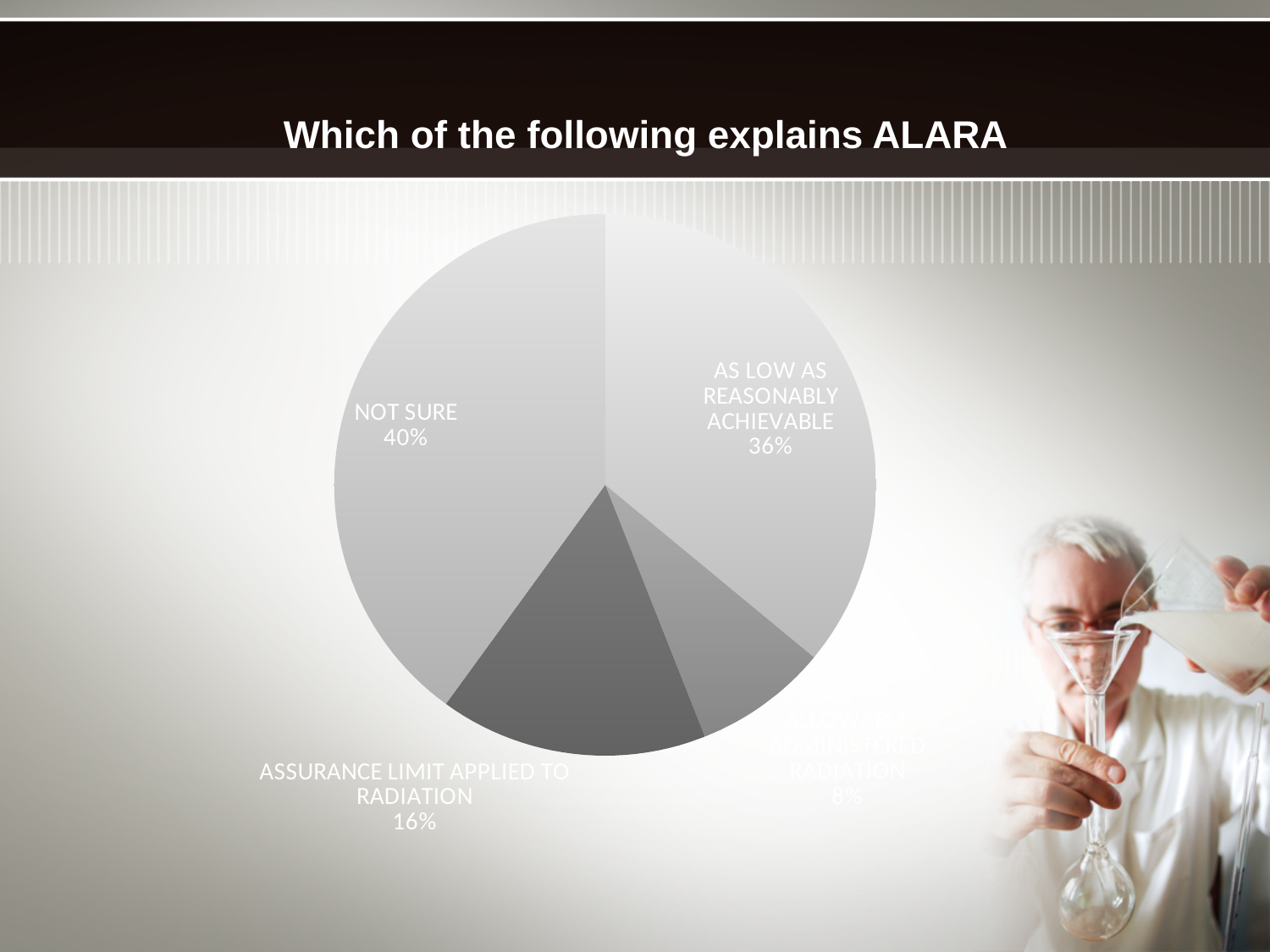
How many slices does the pie chart have? 4 What is the difference in percentage points between NOT SURE and AS LOW AS REASONABLY ACHIEVABLE? 4 percentage points What is the difference in percentage points between AS LOW AS REASONABLY ACHIEVABLE and ASSURANCE LIMIT APPLIED TO RADIATION? 20 percentage points What is the title of the slide? Which of the following explains ALARA Which is larger, ASSURANCE LIMIT APPLIED TO RADIATION or AS LOW AS REASONABLY ACHIEVABLE? AS LOW AS REASONABLY ACHIEVABLE Which slice of the pie chart is the largest? NOT SURE What percentage of the pie is the NOT SURE slice? 40% What percentage is shown for ASSURANCE LIMIT APPLIED TO RADIATION? 16% What kind of chart is shown on the slide? Pie chart Which is larger, the NOT SURE slice or the AS LOW AS REASONABLY ACHIEVABLE slice? NOT SURE What percentage is shown for AS LOW AS REASONABLY ACHIEVABLE? 36% What share of the pie does ASSURANCE LIMIT APPLIED TO RADIATION represent? 16%